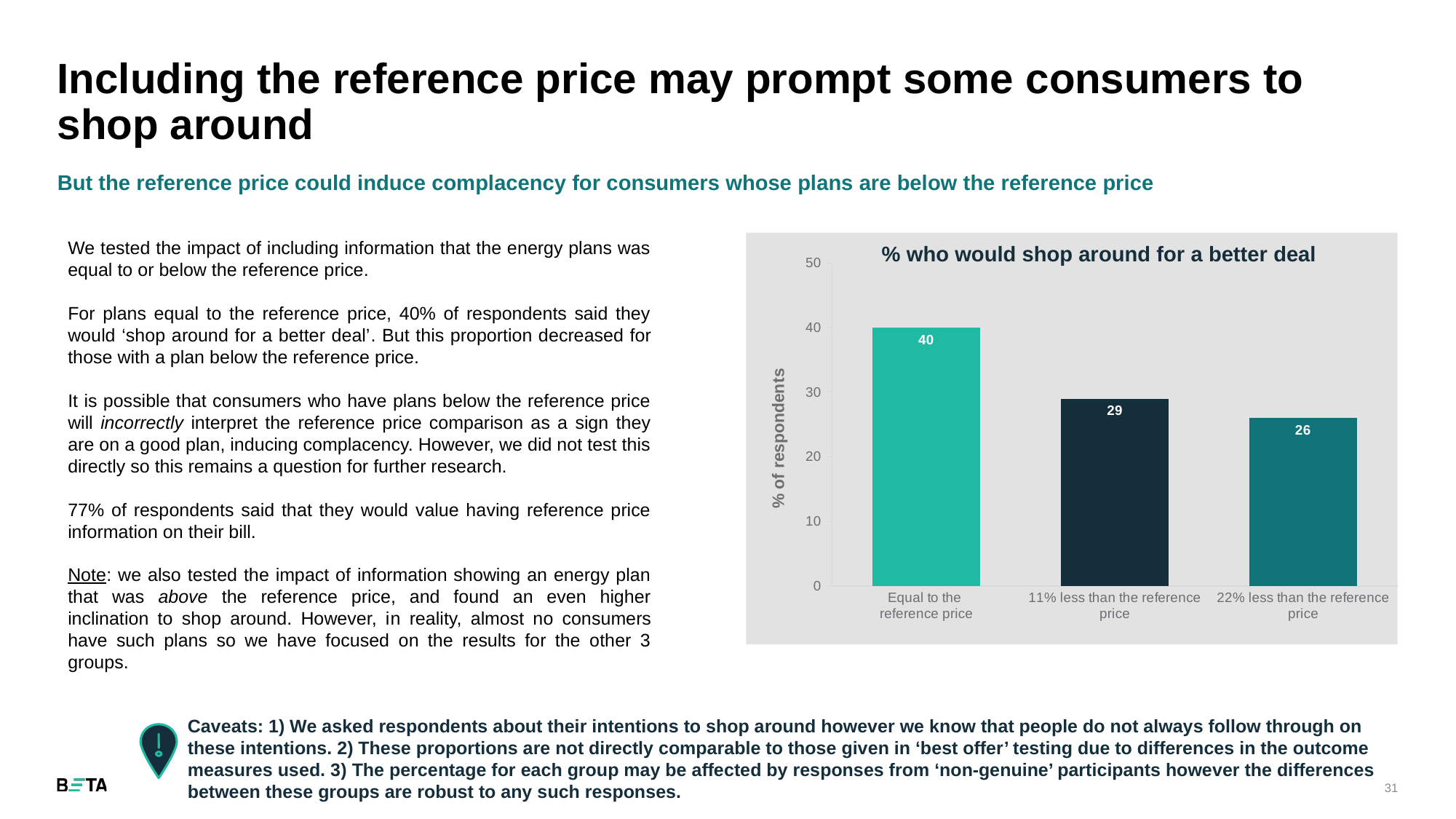
Which is larger: the value for 'Equal to the reference price' or '11% less than the reference price'? Equal to the reference price What is the difference between the values for 'Equal to the reference price' and '22% less than the reference price'? 14 What is the value for '22% less than the reference price'? 26 What is the difference between the values for '11% less than the reference price' and '22% less than the reference price'? 3 Is the value for '11% less than the reference price' greater or less than 30? less What is the value for '11% less than the reference price'? 29 Which category has the lowest value? 22% less than the reference price What is the title of the chart? % who would shop around for a better deal What kind of chart is shown on the slide? Bar chart Which category has the highest value? Equal to the reference price How many categories are shown on the chart? 3 What is the value for 'Equal to the reference price'? 40